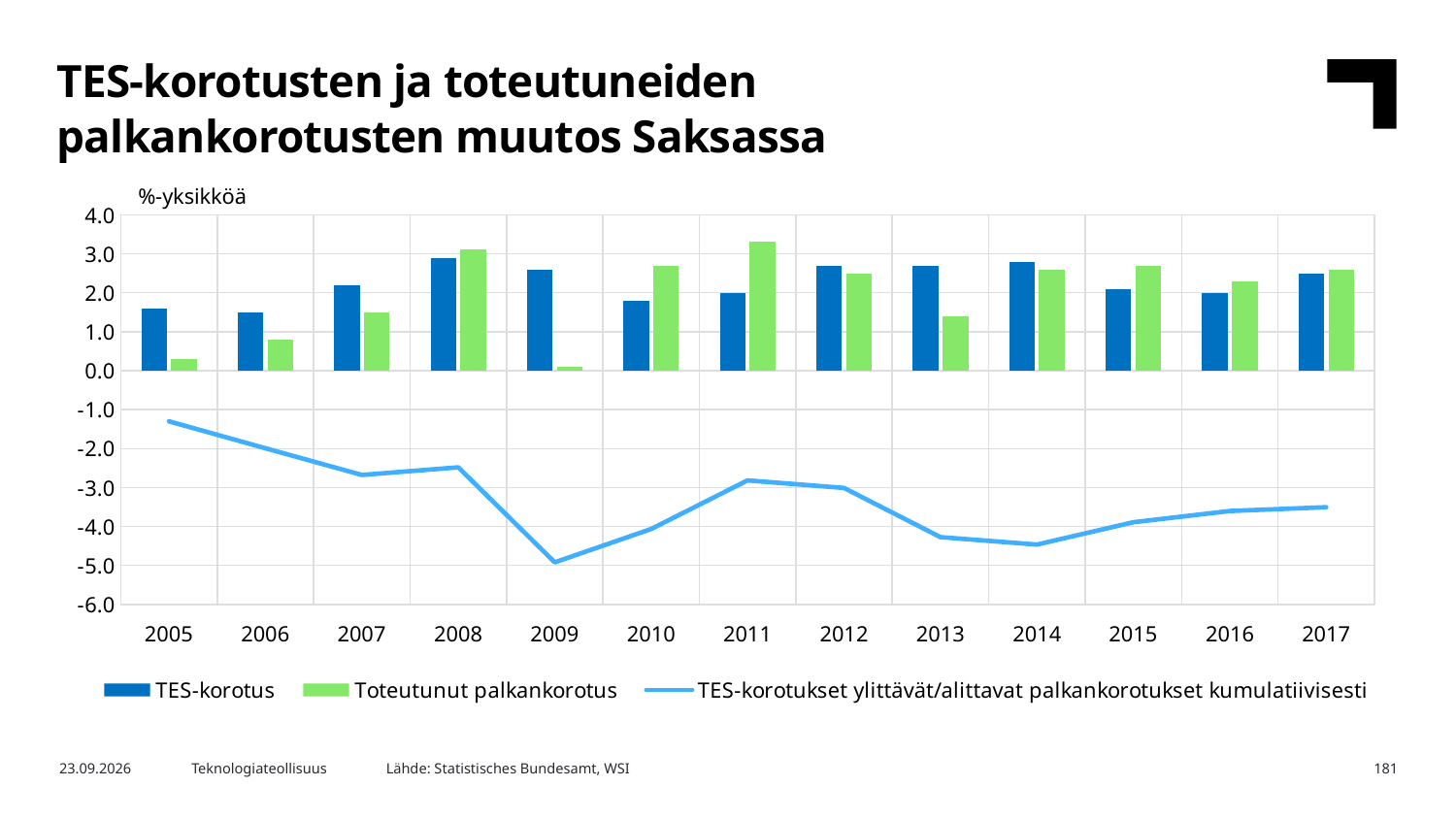
How many series does the legend list? 3 What kind of chart is shown on the slide? A combined bar and line chart In which year is the Toteutunut palkankorotus bar highest? 2011 How many years are shown on the x axis? 13 Does the cumulative line rise or fall from 2005 to 2009? It falls In which year is the Toteutunut palkankorotus bar lowest? 2009 Is the value of the cumulative line in 2009 greater or less than -4.0? less Is the Toteutunut palkankorotus value for 2005 greater or less than 1.0? less In 2009, which is larger: TES-korotus or Toteutunut palkankorotus? TES-korotus In which year does the line 'TES-korotukset ylittävät/alittavat palkankorotukset kumulatiivisesti' reach its lowest point? 2009 In 2011, which is larger: TES-korotus or Toteutunut palkankorotus? Toteutunut palkankorotus